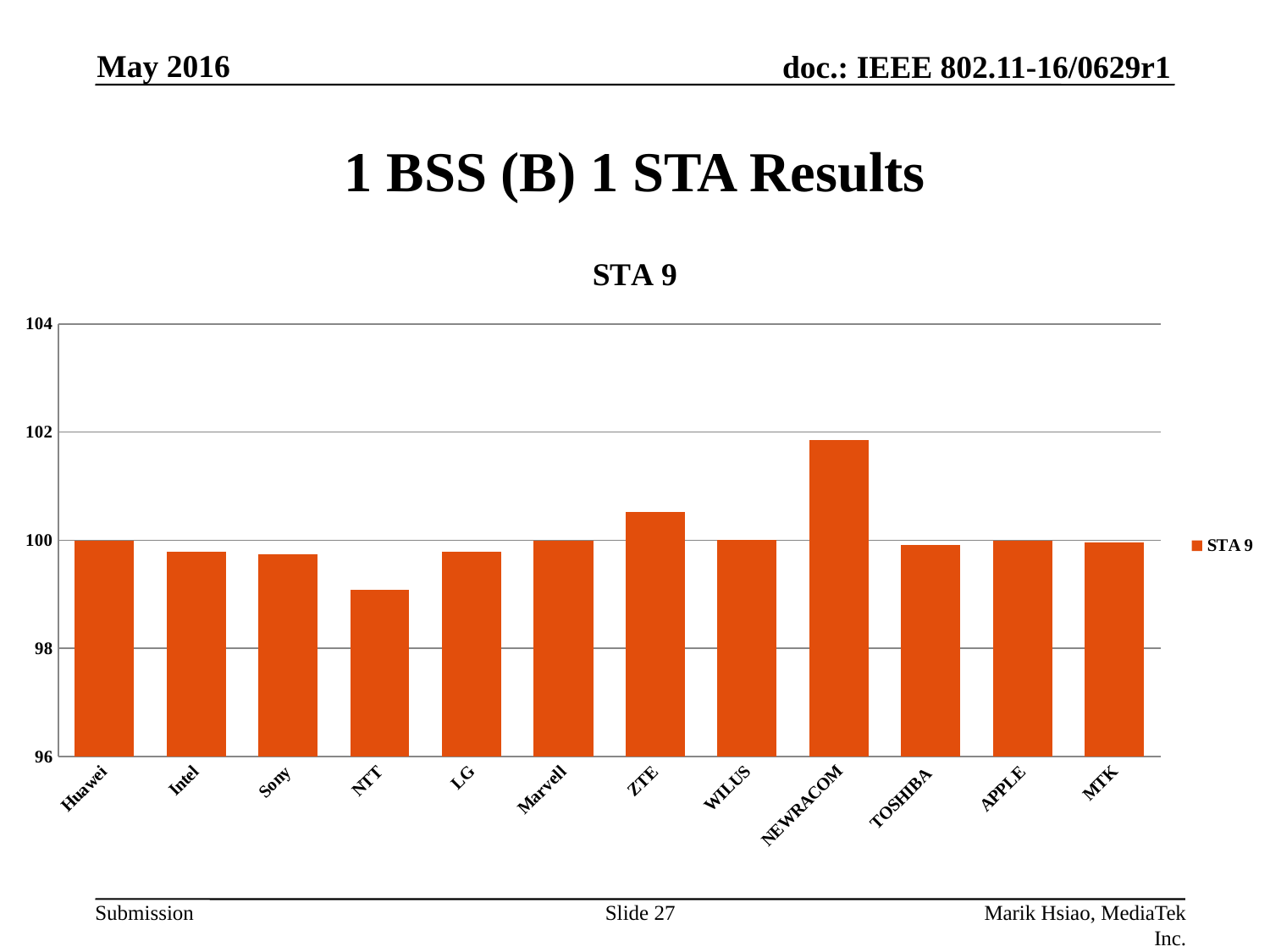
Which category has the highest value in the chart? NEWRACOM What is the title of the chart? STA 9 Is the value for NTT greater or less than 100? less How many series does the legend list? 1 Which has the larger value, NEWRACOM or ZTE? NEWRACOM Which has the larger value, Sony or NTT? Sony Is the value for NEWRACOM greater or less than 102? less What kind of chart is shown on the slide? bar chart Is the value for NEWRACOM greater or less than 100? greater How many categories are shown on the x axis of the chart? 12 Which category has the lowest value in the chart? NTT